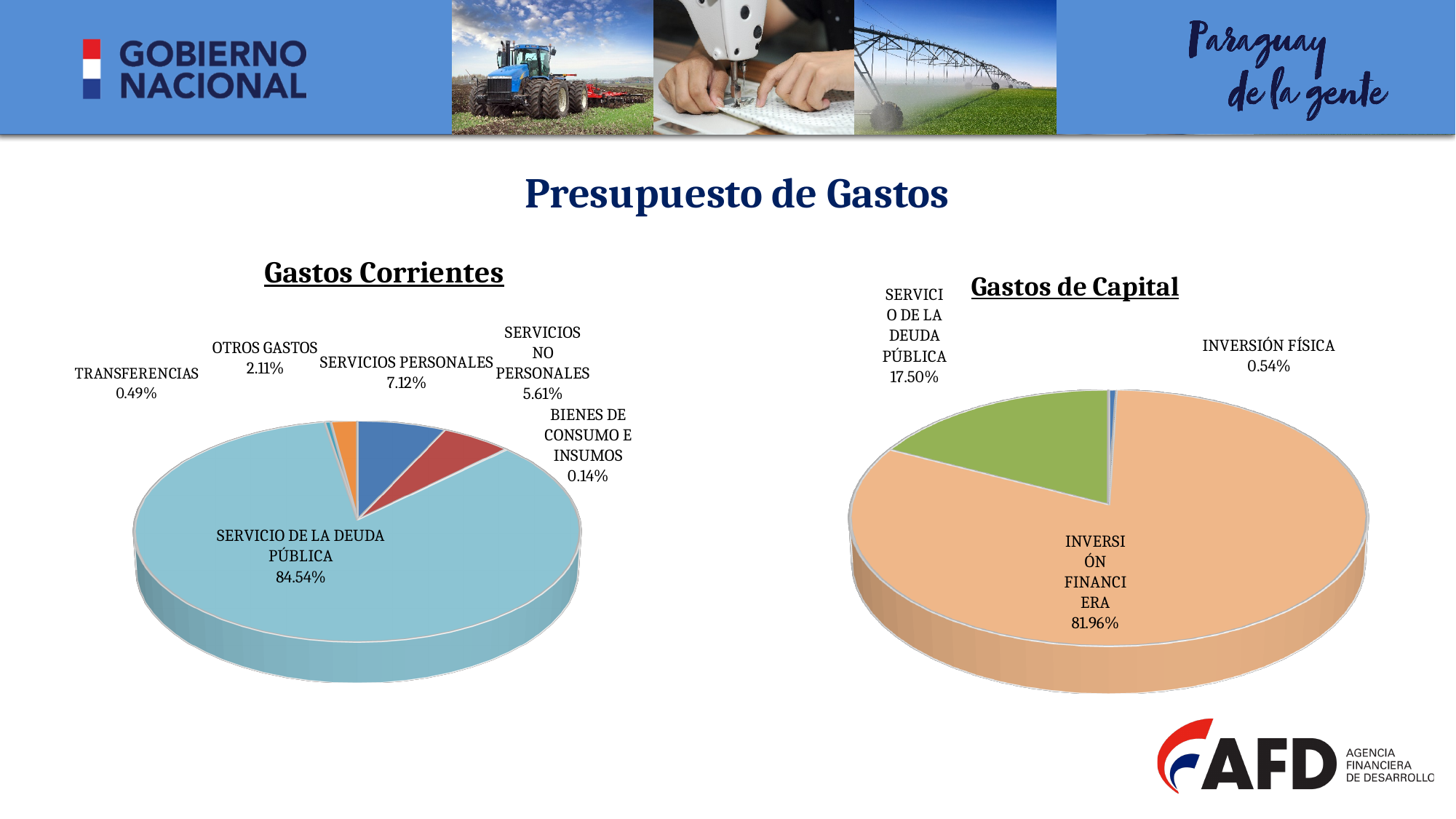
In the Gastos Corrientes chart, what is the value for BIENES DE CONSUMO E INSUMOS? 0.14% In the Gastos Corrientes chart, what share does SERVICIO DE LA DEUDA PÚBLICA have? 84.54% In the Gastos Corrientes chart, how many categories are shown? 6 In the Gastos Corrientes chart, what is the value for SERVICIOS PERSONALES? 7.12% In the Gastos Corrientes chart, what is the difference between SERVICIOS PERSONALES and SERVICIOS NO PERSONALES? 1.51% In the Gastos de Capital chart, which category has the largest share? INVERSIÓN FINANCIERA What type of chart is the Gastos de Capital chart? Pie chart In the Gastos Corrientes chart, which is larger, OTROS GASTOS or TRANSFERENCIAS? OTROS GASTOS In the Gastos Corrientes chart, which category has the smallest share? BIENES DE CONSUMO E INSUMOS In the Gastos de Capital chart, what is the value for SERVICIO DE LA DEUDA PÚBLICA? 17.50% In the Gastos de Capital chart, how many categories are shown? 3 In the Gastos de Capital chart, what is the value for INVERSIÓN FÍSICA? 0.54%